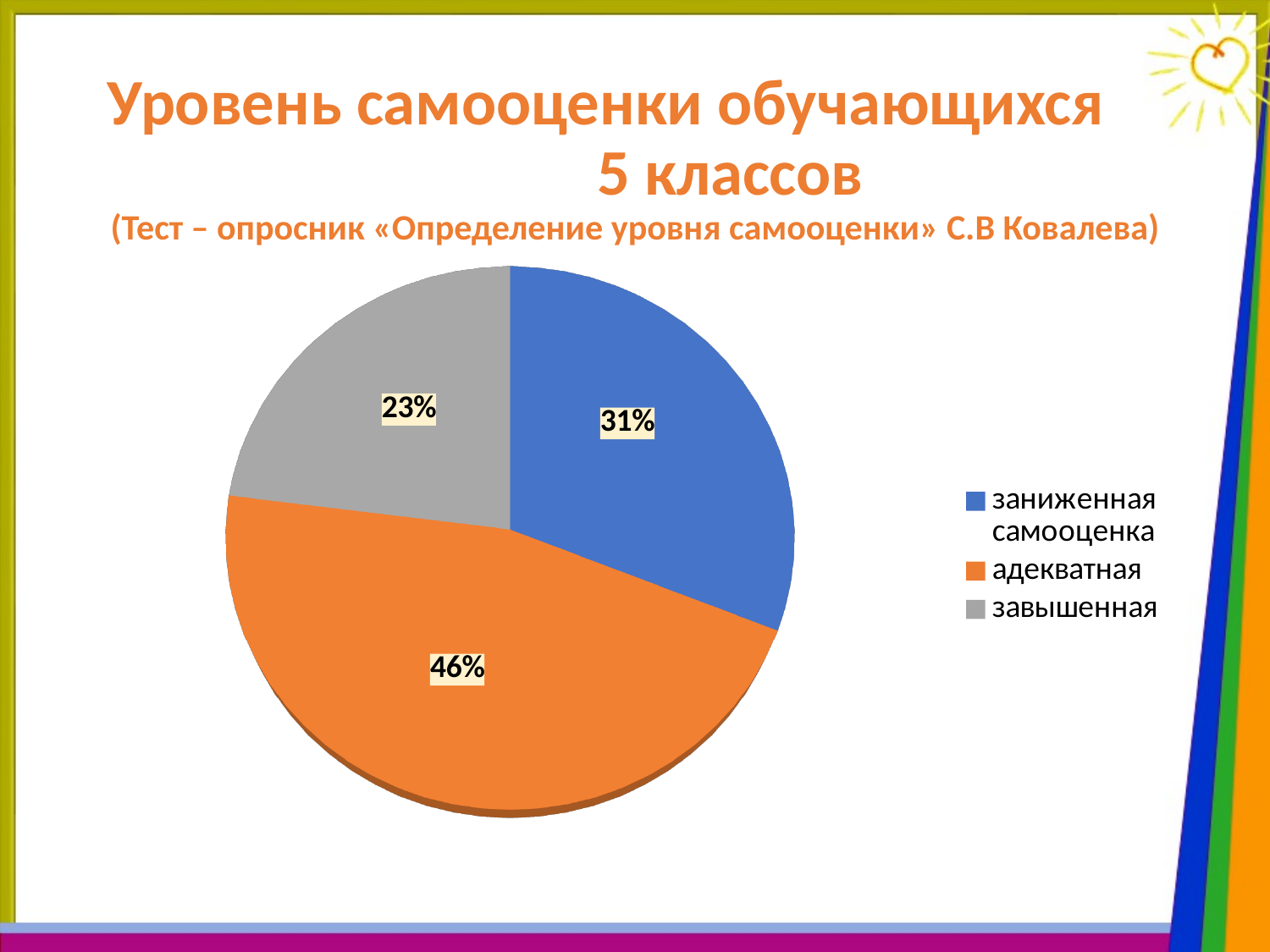
How many entries does the legend list? 3 What share of the pie is labelled 'заниженная самооценка'? 31% Which category has the smallest slice of the pie? завышенная Which category has the largest slice of the pie? адекватная What is the difference in percentage points between 'заниженная самооценка' and 'завышенная'? 8 What type of chart is shown on the slide? pie chart How many slices does the pie chart have? 3 Which is larger: the slice for 'заниженная самооценка' or the slice for 'завышенная'? заниженная самооценка What colour is the slice for 'адекватная'? orange What share of the pie is labelled 'адекватная'? 46% What is the difference in percentage points between 'адекватная' and 'завышенная'? 23 What share of the pie is labelled 'завышенная'? 23%